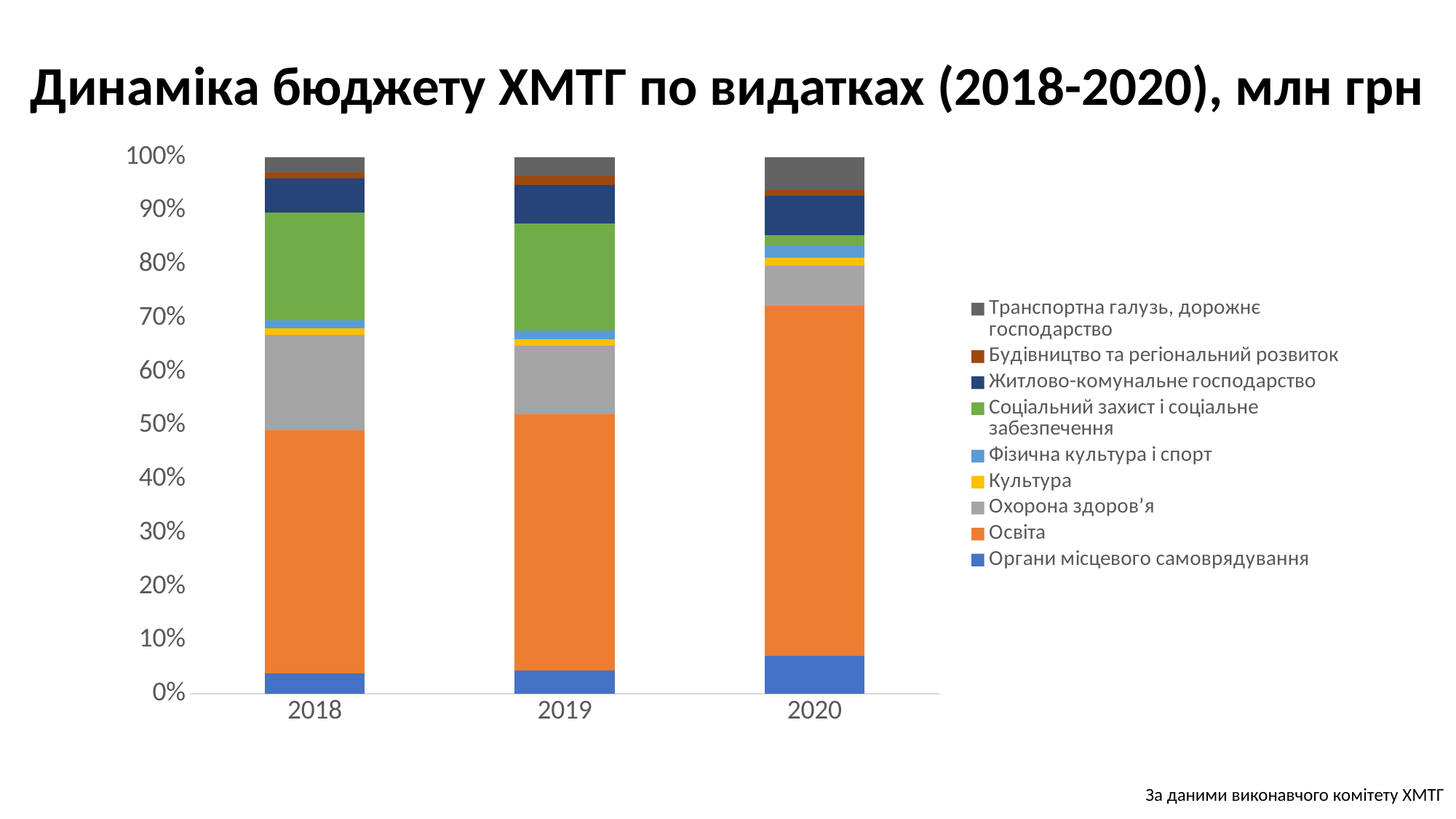
How many series does the legend list? 9 Does the share for Освіта rise or fall from 2018 to 2020? rise How many years are shown on the x axis of the chart? 3 In which year is the share for Освіта the largest? 2020 Is the share for Освіта in 2020 greater or less than 50%? greater What does each stacked bar total on the percentage axis? 100% What kind of chart is shown on the slide? Stacked bar chart Which legend entry is shown in orange? Освіта What is the title of the chart? Динаміка бюджету ХМТГ по видатках (2018-2020), млн грн In which year is the share for Соціальний захист і соціальне забезпечення the smallest? 2020 Which year has the larger share for Транспортна галузь, дорожнє господарство, 2018 or 2020? 2020 Is the share for Соціальний захист і соціальне забезпечення in 2020 greater or less than 10%? less